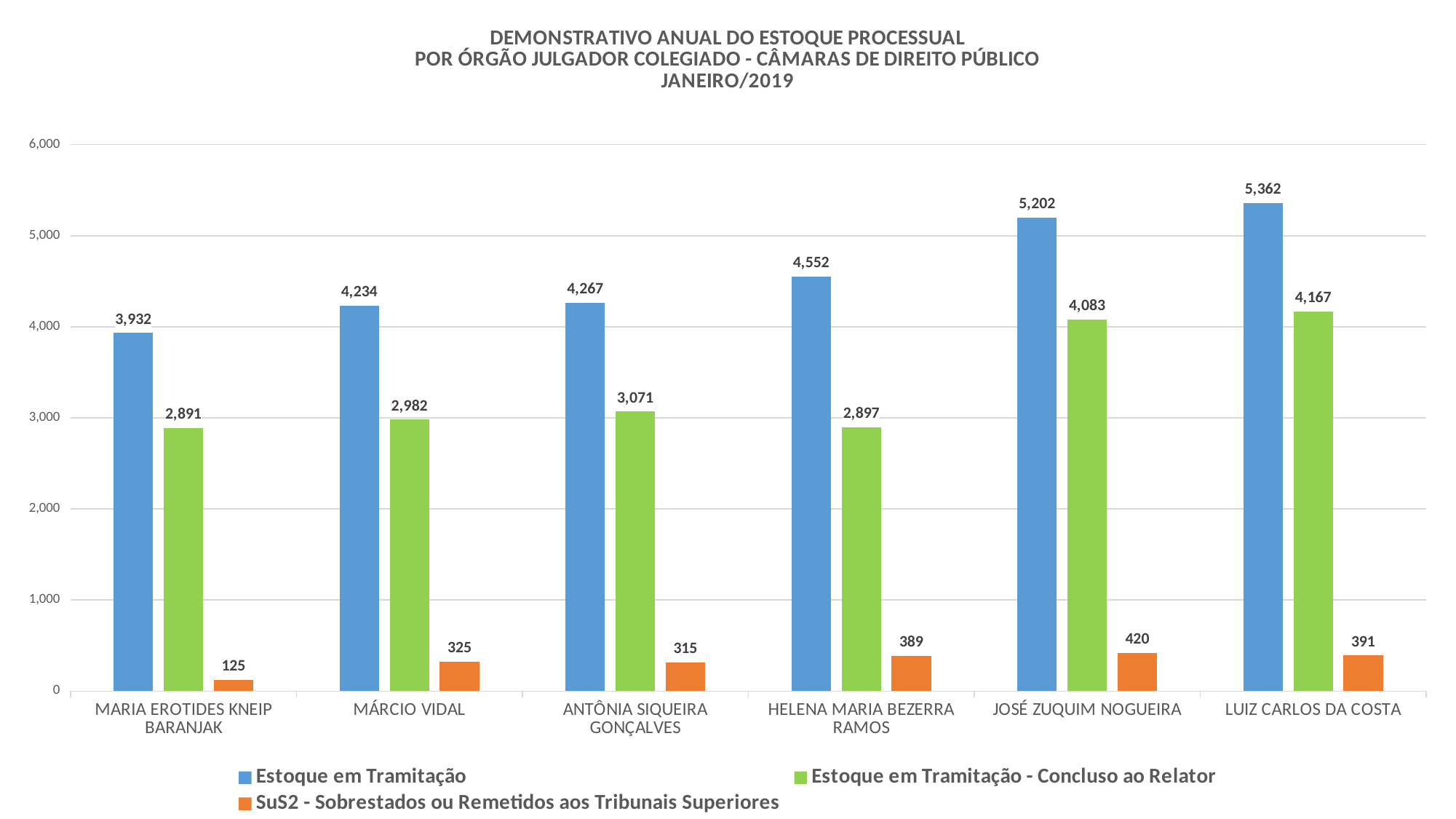
What kind of chart is shown on the slide? bar chart Is the Estoque em Tramitação value for HELENA MARIA BEZERRA RAMOS greater or less than 4,000? greater Which category has the lowest value for SuS2 - Sobrestados ou Remetidos aos Tribunais Superiores? MARIA EROTIDES KNEIP BARANJAK How many series does the legend list? 3 What is the difference between the Estoque em Tramitação values for JOSÉ ZUQUIM NOGUEIRA and MARIA EROTIDES KNEIP BARANJAK? 1,270 Which colour represents the SuS2 - Sobrestados ou Remetidos aos Tribunais Superiores series? orange Which is larger: the Estoque em Tramitação - Concluso ao Relator value for ANTÔNIA SIQUEIRA GONÇALVES or for HELENA MARIA BEZERRA RAMOS? ANTÔNIA SIQUEIRA GONÇALVES What is the value of SuS2 - Sobrestados ou Remetidos aos Tribunais Superiores for HELENA MARIA BEZERRA RAMOS? 389 What is the value of Estoque em Tramitação - Concluso ao Relator for MÁRCIO VIDAL? 2,982 What is the value of Estoque em Tramitação for LUIZ CARLOS DA COSTA? 5,362 How many categories are shown on the x axis? 6 Which category has the highest value for Estoque em Tramitação? LUIZ CARLOS DA COSTA